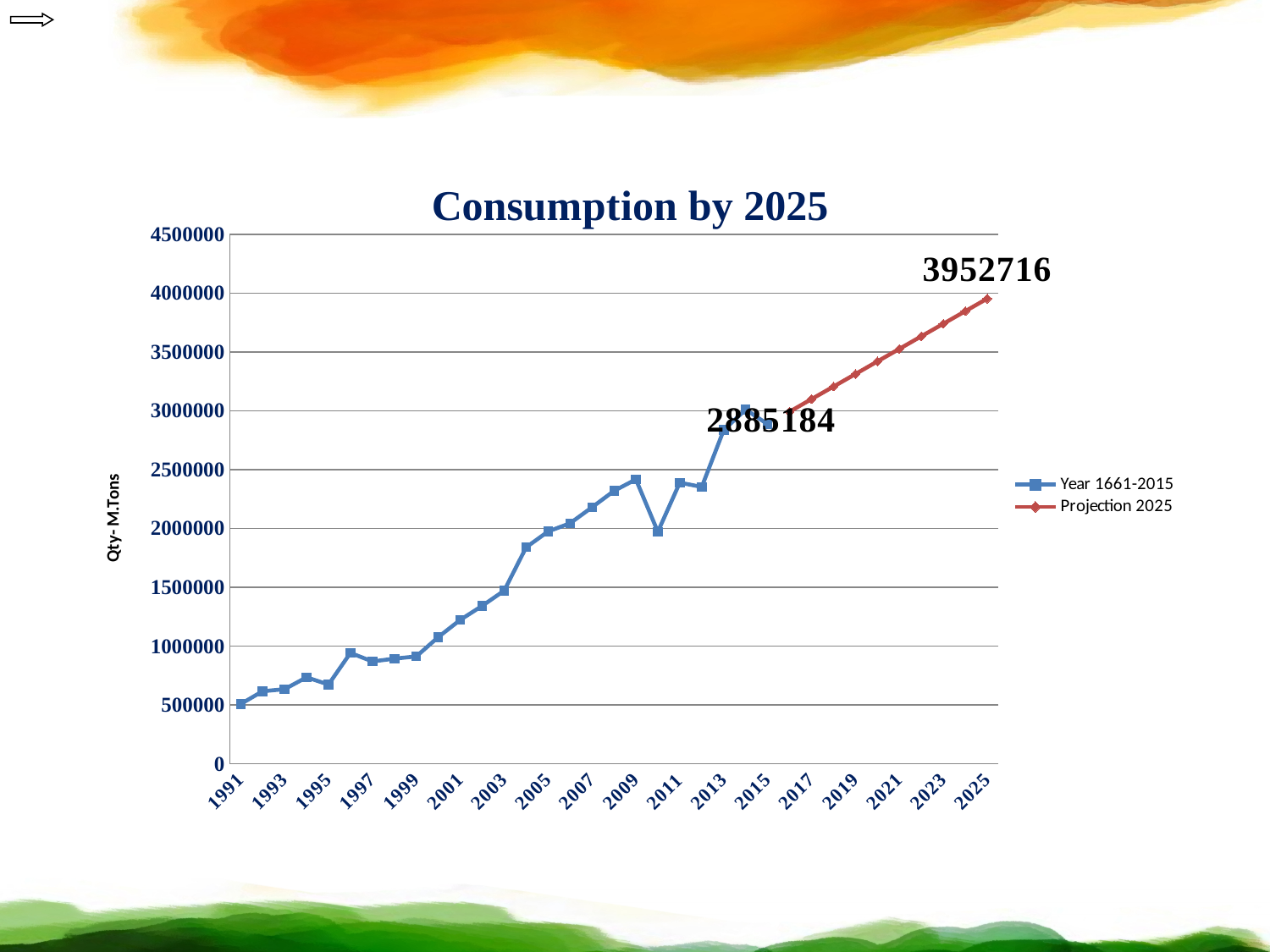
Which year has the lowest value on the chart? 1991 Is the value for 1991 greater or less than 1000000? less What kind of chart is shown? line chart Which year has the highest value on the chart? 2025 What is the difference between the labelled 2025 projection and the labelled 2015 value? 1067532 Which year has the larger value, 2009 or 2010? 2009 How many series does the legend list? 2 What is the labelled value for 2015? 2885184 What is the title of the vertical axis? Qty- M.Tons Is the value for 2001 greater or less than 1000000? greater What is the labelled value for the 2025 projection? 3952716 Is the value for 2009 greater or less than 2000000? greater